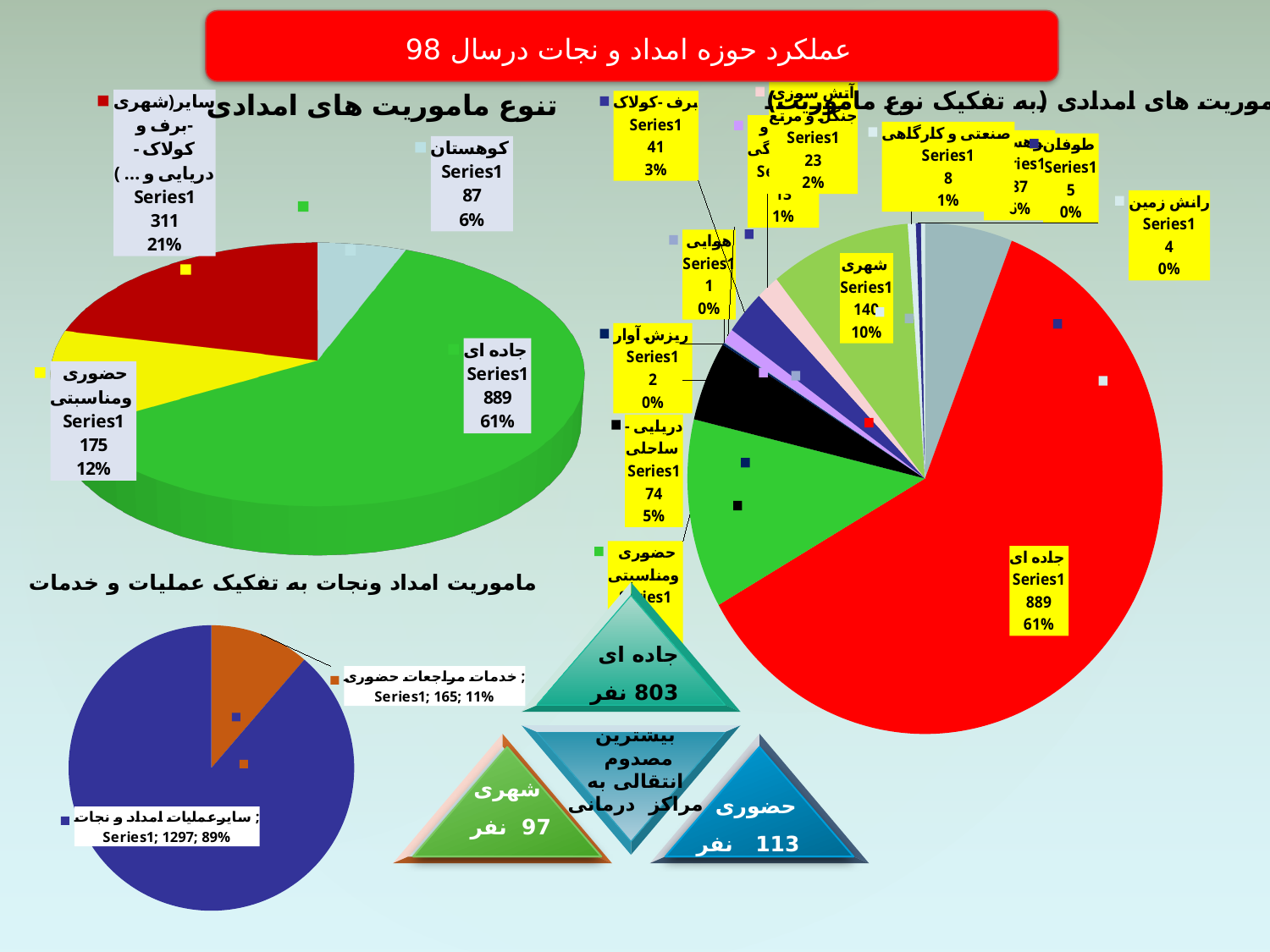
In the bottom-left pie chart (ماموریت امداد ونجات به تفکیک عملیات و خدمات), what is the value for خدمات مراجعات حضوری? 165 In the top-left pie chart (تنوع ماموریت های امدادی), what is the difference between the value for سایر (311) and the value for حضوری ومناسبتی (175)? 136 What kind of chart is the bottom-left chart titled ماموریت امداد ونجات به تفکیک عملیات و خدمات? pie chart How many slices does the bottom-left pie chart (ماموریت امداد ونجات به تفکیک عملیات و خدمات) have? 2 In the top-left pie chart (تنوع ماموریت های امدادی), what is the value for کوهستان? 87 In the top-left pie chart (تنوع ماموریت های امدادی), which category has the largest value? جاده ای In the top-left pie chart (تنوع ماموریت های امدادی), what share of the pie is جاده ای? 61% In the top-right pie chart (ماموریت های امدادی به تفکیک نوع ماموریت), what is the value for دریایی - ساحلی? 74 In the top-right pie chart (ماموریت های امدادی به تفکیک نوع ماموریت), which is larger: برف - کولاک or آتش سوزی جنگل و مرتع? برف - کولاک In the bottom-left pie chart (ماموریت امداد ونجات به تفکیک عملیات و خدمات), what share of the pie is سایرعملیات امداد و نجات? 89% In the top-right pie chart (ماموریت های امدادی به تفکیک نوع ماموریت), what is the value for شهری? 140 In the top-left pie chart (تنوع ماموریت های امدادی), which category has the smallest value? کوهستان